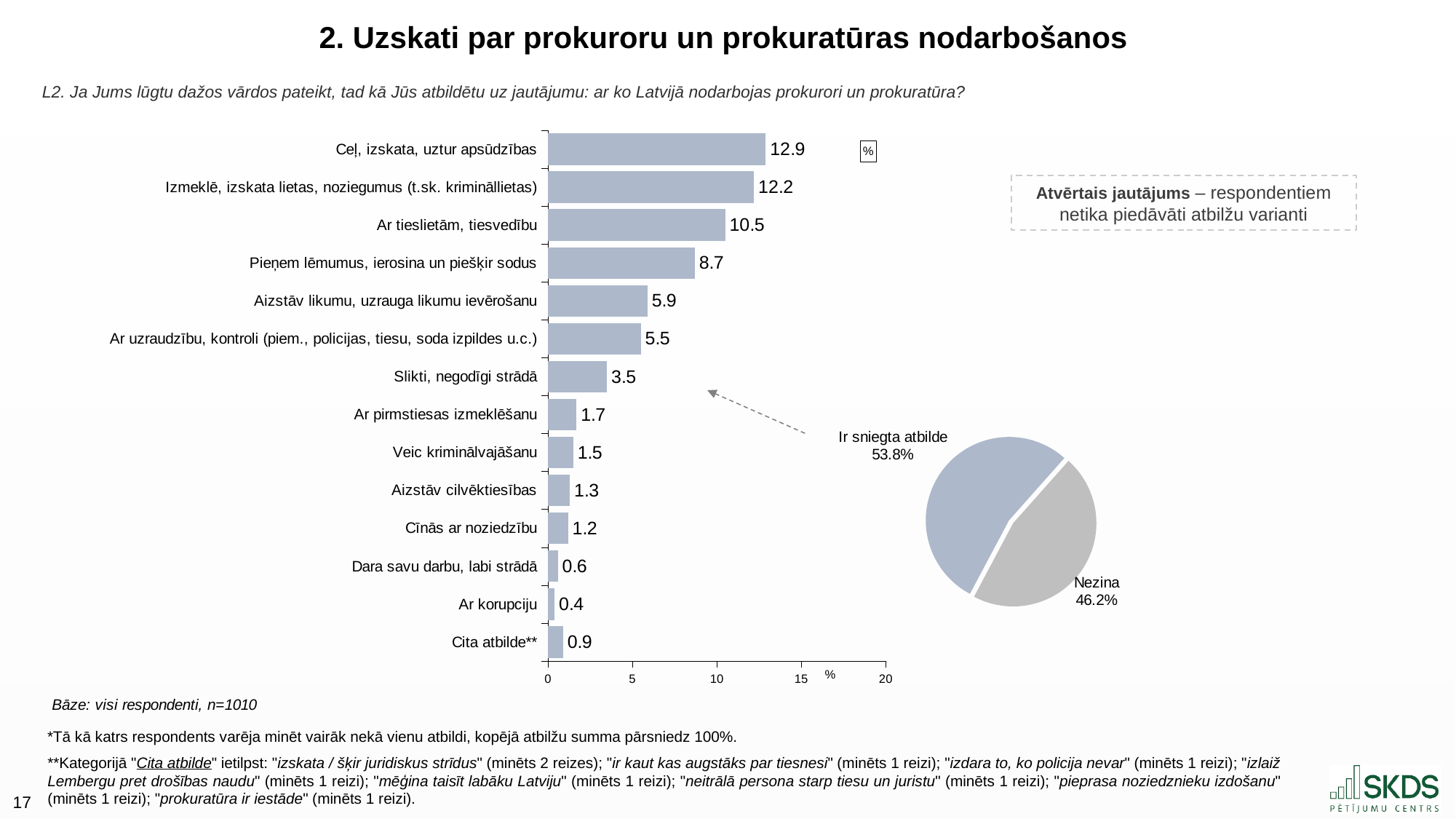
In the bar chart, is the value for "Izmeklē, izskata lietas, noziegumus (t.sk. krimināllietas)" greater or less than 10? greater In the bar chart, what is the difference between "Ar tieslietām, tiesvedību" and "Pieņem lēmumus, ierosina un piešķir sodus"? 1.8 In the bar chart, what is the value for "Aizstāv likumu, uzrauga likumu ievērošanu"? 5.9 How many categories does the bar chart show? 14 What kind of chart is the chart on the left of the slide? bar chart In the bar chart, what is the value for "Ceļ, izskata, uztur apsūdzības"? 12.9 In the bar chart, which category has the highest value? Ceļ, izskata, uztur apsūdzības In the bar chart, which is larger: "Slikti, negodīgi strādā" or "Ar pirmstiesas izmeklēšanu"? Slikti, negodīgi strādā What kind of chart is the chart on the right of the slide? pie chart In the pie chart, what share is "Nezina"? 46.2% In the pie chart, what share is "Ir sniegta atbilde"? 53.8% In the bar chart, which category has the lowest value? Ar korupciju